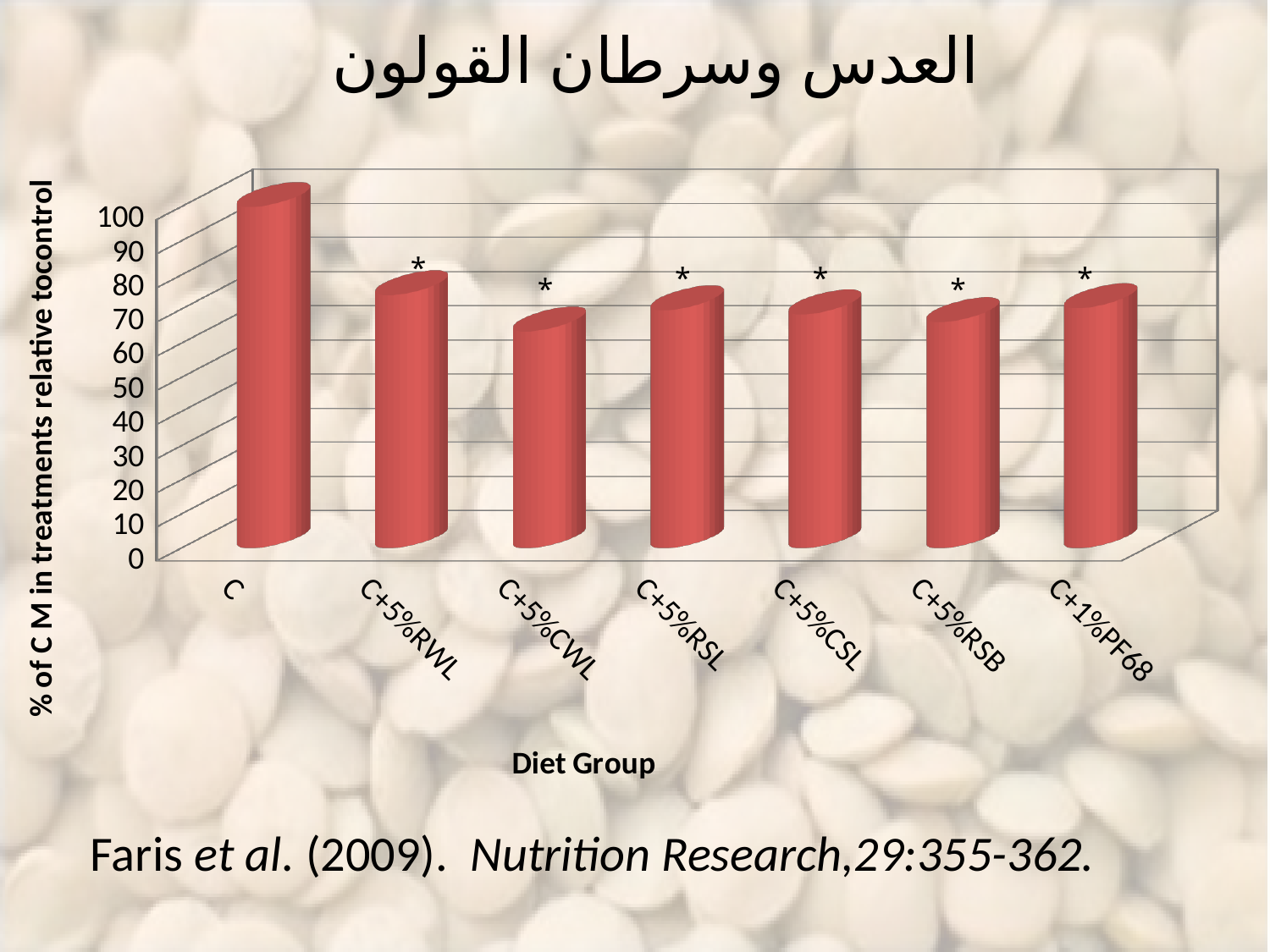
Which diet group has the highest value? C What is the title of the x axis? Diet Group How many diet groups are plotted on the x axis? 7 Is the value for C+5%RWL greater or less than 70? greater What kind of chart is shown on the slide? Bar chart Is the value for C+5%CWL greater or less than 80? less Is the value for C+5%CSL greater or less than 90? less How many bars are marked with an asterisk? 6 Which is larger, the value for C or the value for C+5%RWL? C Which is larger, the value for C+5%RWL or the value for C+5%CWL? C+5%RWL